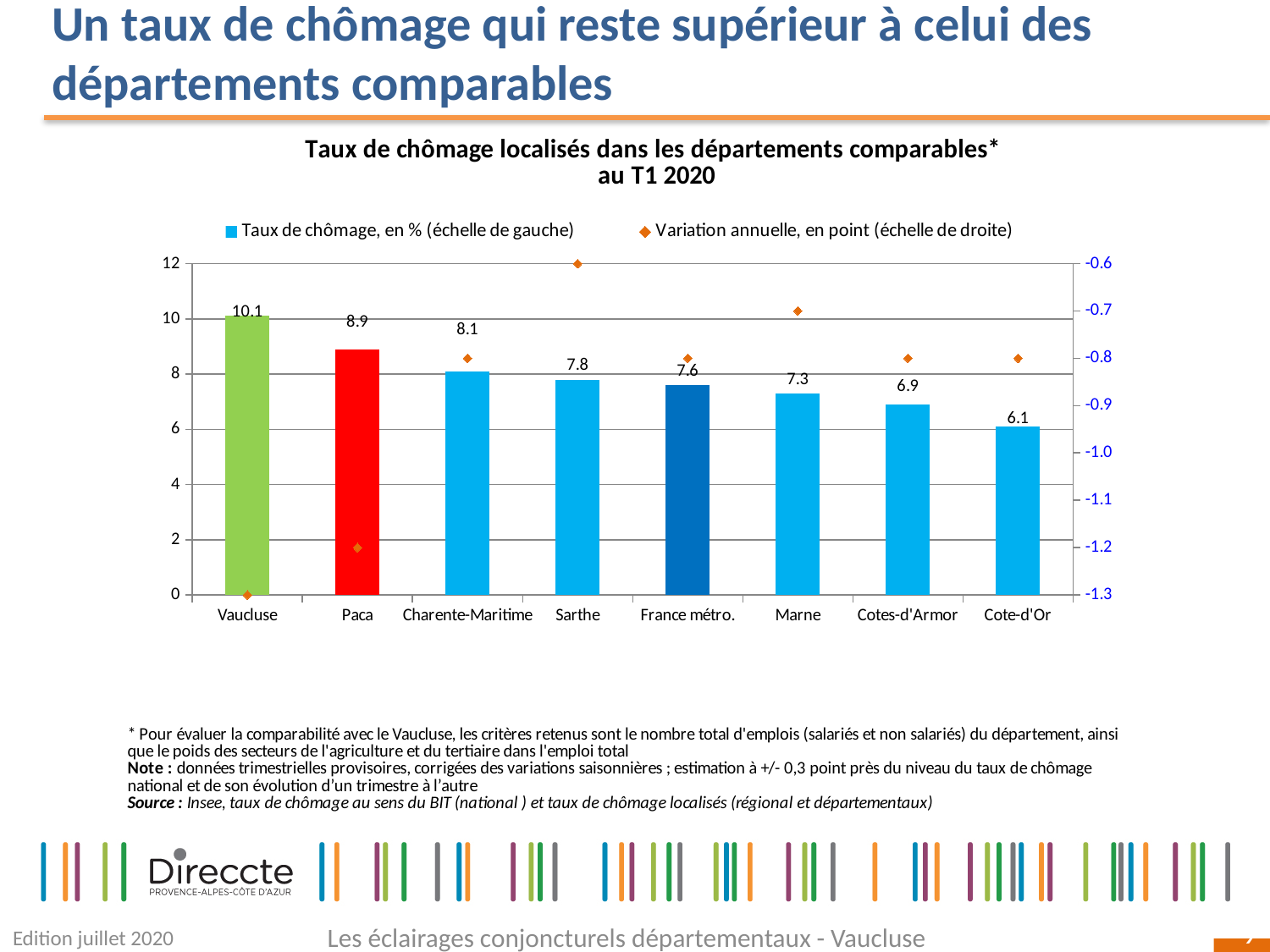
What is the unemployment rate shown for France métro.? 7.6 What colour is the bar for Paca? red How many series does the legend list? 2 Is the annual variation (Variation annuelle) for Vaucluse greater or less than -1.0? less Which has a higher unemployment rate, Marne or Cotes-d'Armor? Marne What is the unemployment rate (taux de chômage) shown for Vaucluse? 10.1 What is the unemployment rate shown for Cote-d'Or? 6.1 Which category has the highest unemployment rate bar? Vaucluse How many categories are shown on the x axis? 8 What is the difference between the unemployment rates of Vaucluse and Paca? 1.2 Do the unemployment rate bars rise or fall from left to right along the x axis? fall Which category has the lowest unemployment rate bar? Cote-d'Or